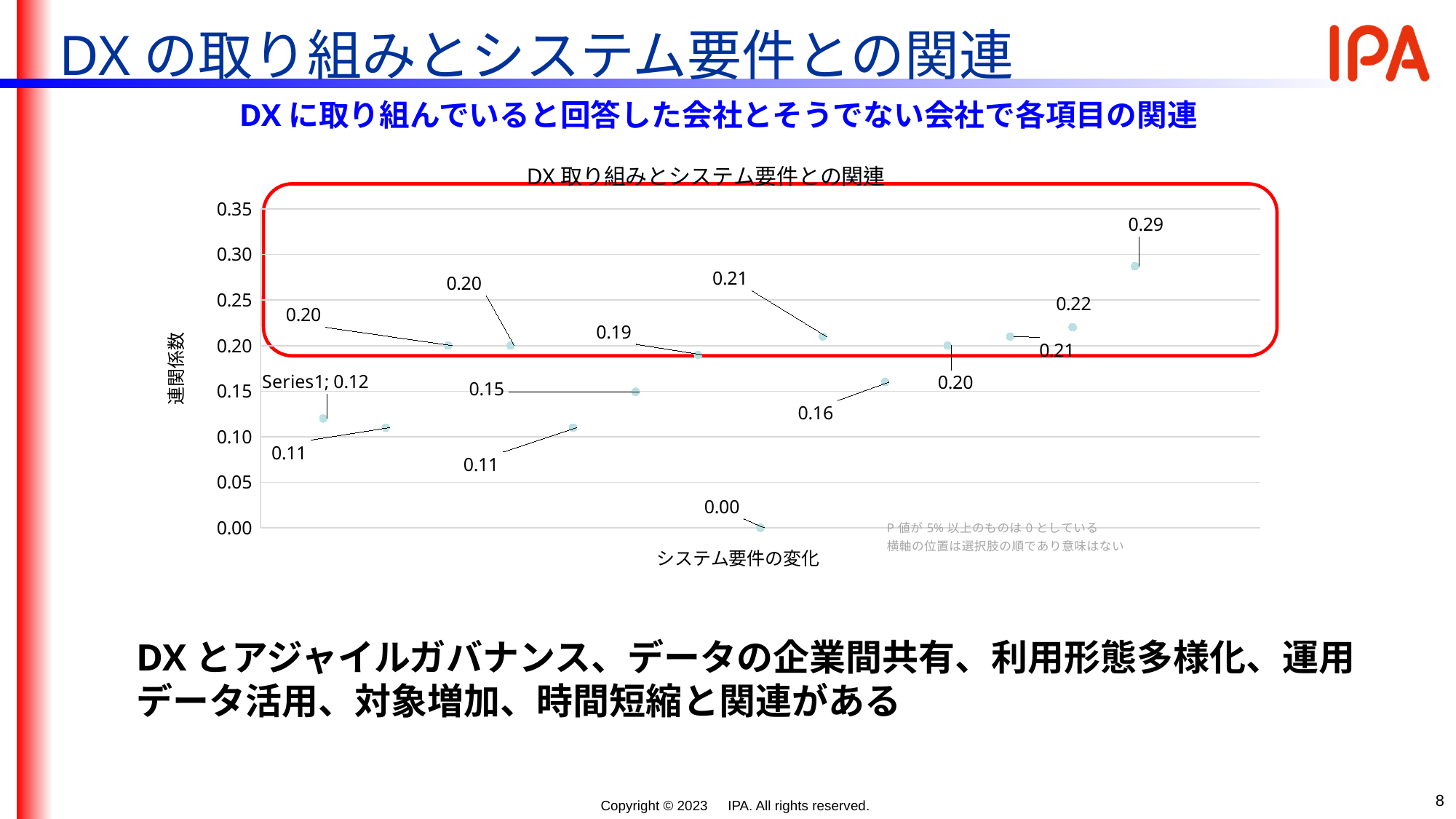
What is the difference between the highest plotted value (0.29) and the second highest (0.22)? 0.07 How many data points are plotted in the chart? 14 What is the highest value plotted in the chart? 0.29 How many data points in the chart are labeled 0.20? 3 What is the lowest value plotted in the chart? 0.00 Is the highest plotted value in the chart greater or less than 0.25? greater What is the difference between the highest plotted value and the lowest plotted value? 0.29 What kind of chart is shown on the slide? scatter chart How many data points in the chart are labeled 0.11? 2 What is the maximum value shown on the vertical axis of the chart? 0.35 What is the label of the vertical axis of the chart? 連関係数 What is the title of the chart? DX取り組みとシステム要件との関連